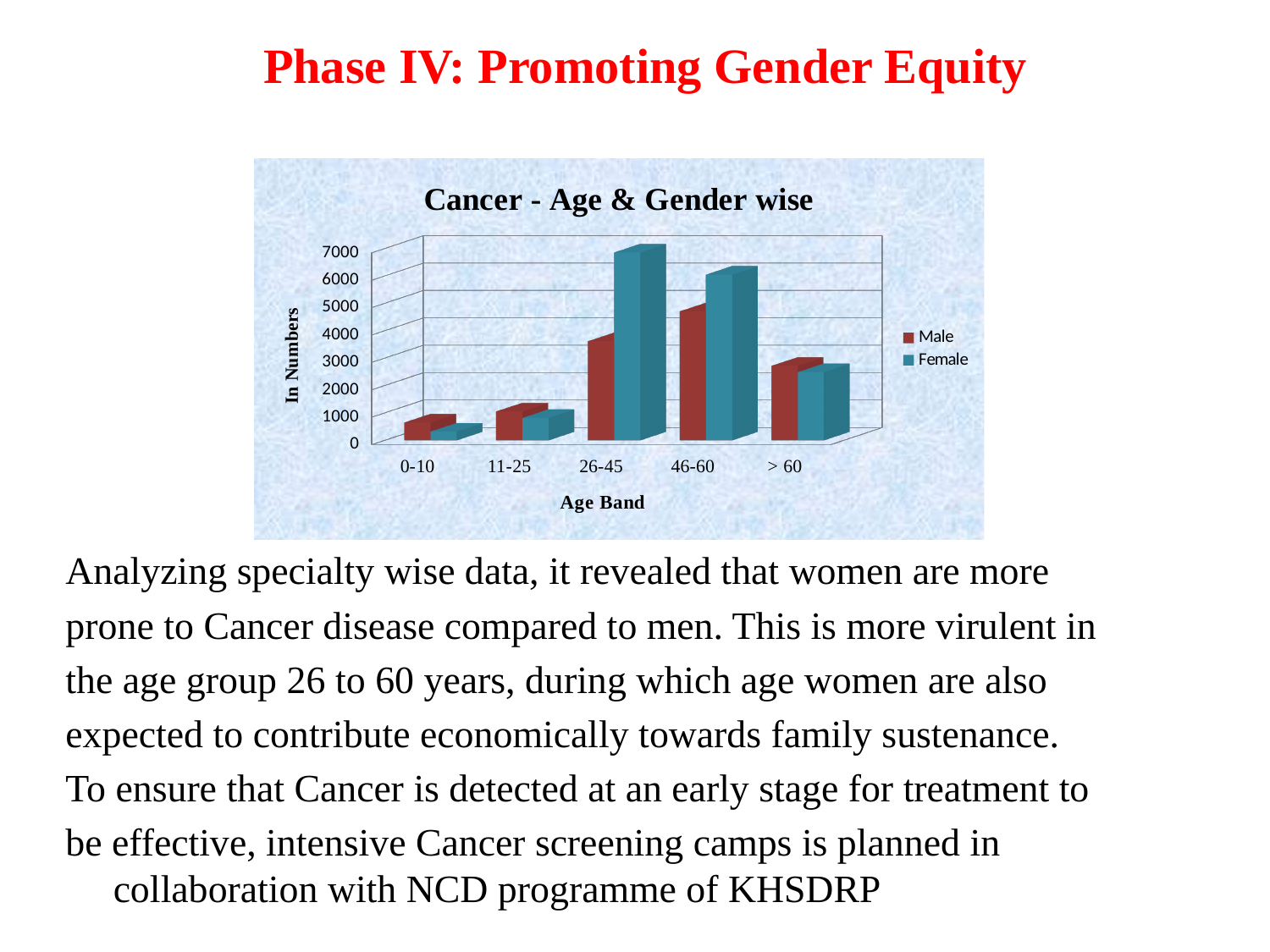
Which age band has the highest Female value in the chart? 26-45 In the 26-45 age band, which is larger, the Male value or the Female value? Female Is the Male value for the 0-10 age band greater or less than 1000? less What is the label of the vertical axis of the chart? In Numbers Is the Male value for the 46-60 age band greater or less than 4000? greater Is the Female value for the 26-45 age band greater or less than 6000? greater What kind of chart is shown on the slide? bar chart Which age band has the highest Male value in the chart? 46-60 Which age band has the lowest Female value in the chart? 0-10 How many age bands are shown on the x axis of the chart? 5 How many series does the chart's legend list? 2 What is the title of the chart? Cancer - Age & Gender wise